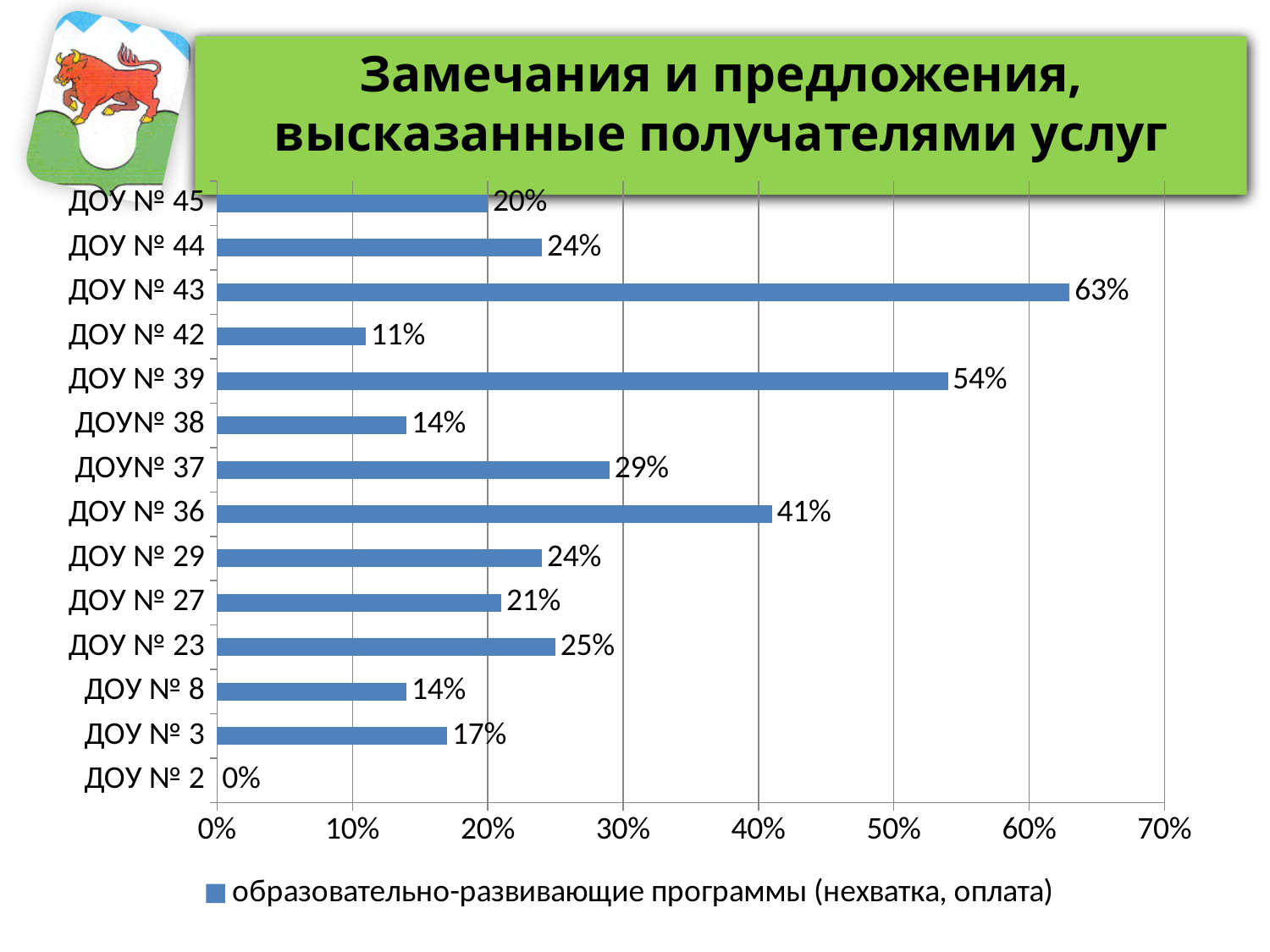
What kind of chart is shown on the slide? bar chart What is the legend entry of the series shown? образовательно-развивающие программы (нехватка, оплата) What is the value for ДОУ № 39? 54% What is the value for ДОУ № 2? 0% How many categories are shown on the chart? 14 Which category has the highest value? ДОУ № 43 Which category has the lowest value? ДОУ № 2 What is the difference between the values for ДОУ № 43 and ДОУ № 39? 9% What is the value for ДОУ № 43? 63% How many series does the legend list? 1 Which is larger, the value for ДОУ № 36 or the value for ДОУ№ 37? ДОУ № 36 What is the value for ДОУ № 42? 11%